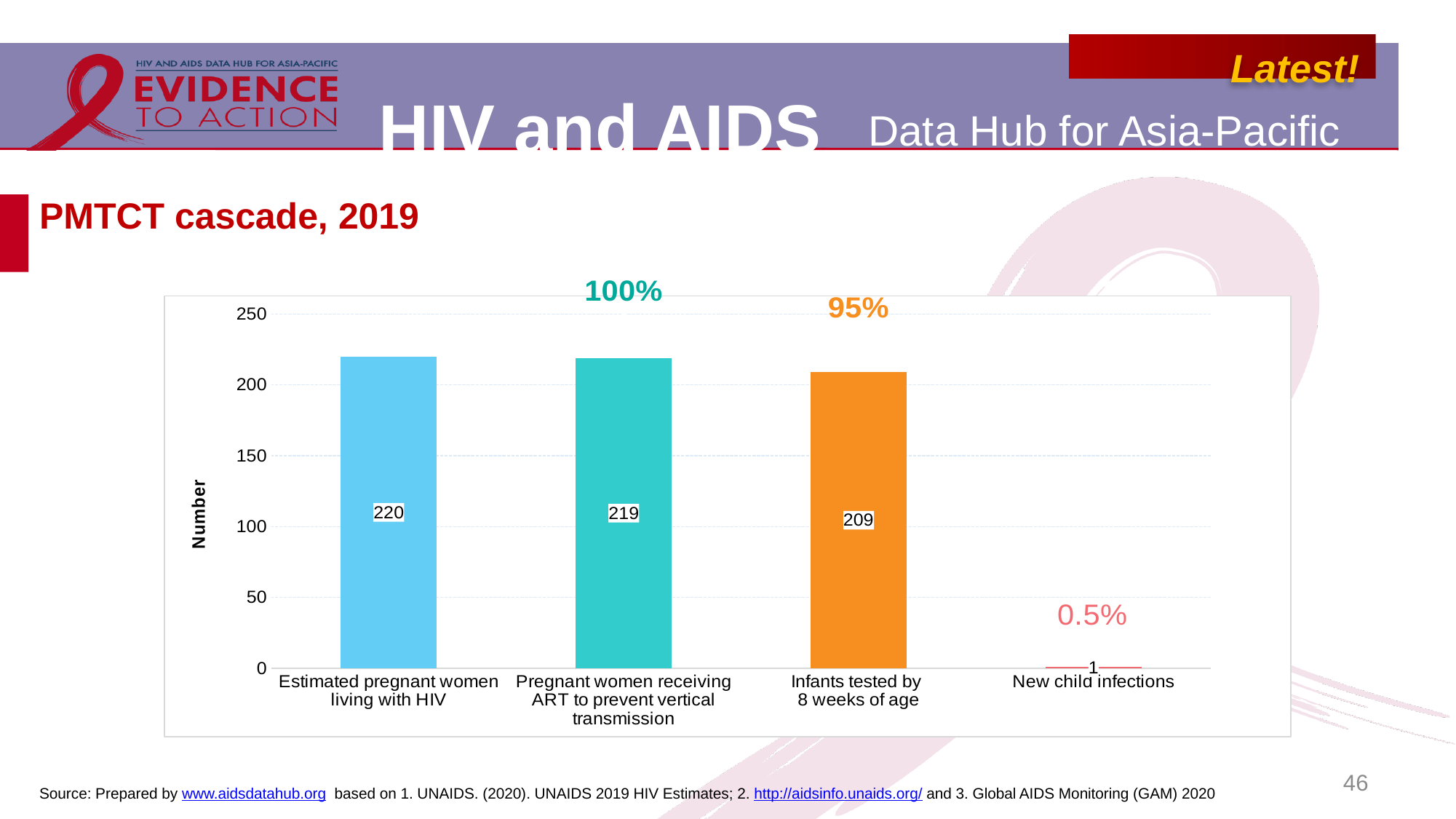
What is the value for Pregnant women receiving ART to prevent vertical transmission? 219 What percentage is shown above the Infants tested by 8 weeks of age bar? 95% Is the value for Infants tested by 8 weeks of age greater or less than 200? greater What kind of chart is shown on the slide? bar chart What is the value for Infants tested by 8 weeks of age? 209 Which is larger: Pregnant women receiving ART to prevent vertical transmission or Infants tested by 8 weeks of age? Pregnant women receiving ART to prevent vertical transmission What is the value for New child infections? 1 What is the value for Estimated pregnant women living with HIV? 220 How many categories are shown on the x axis? 4 What is the difference between Estimated pregnant women living with HIV and Infants tested by 8 weeks of age? 11 Do the values rise or fall from left to right along the x axis? fall Which category has the lowest value? New child infections